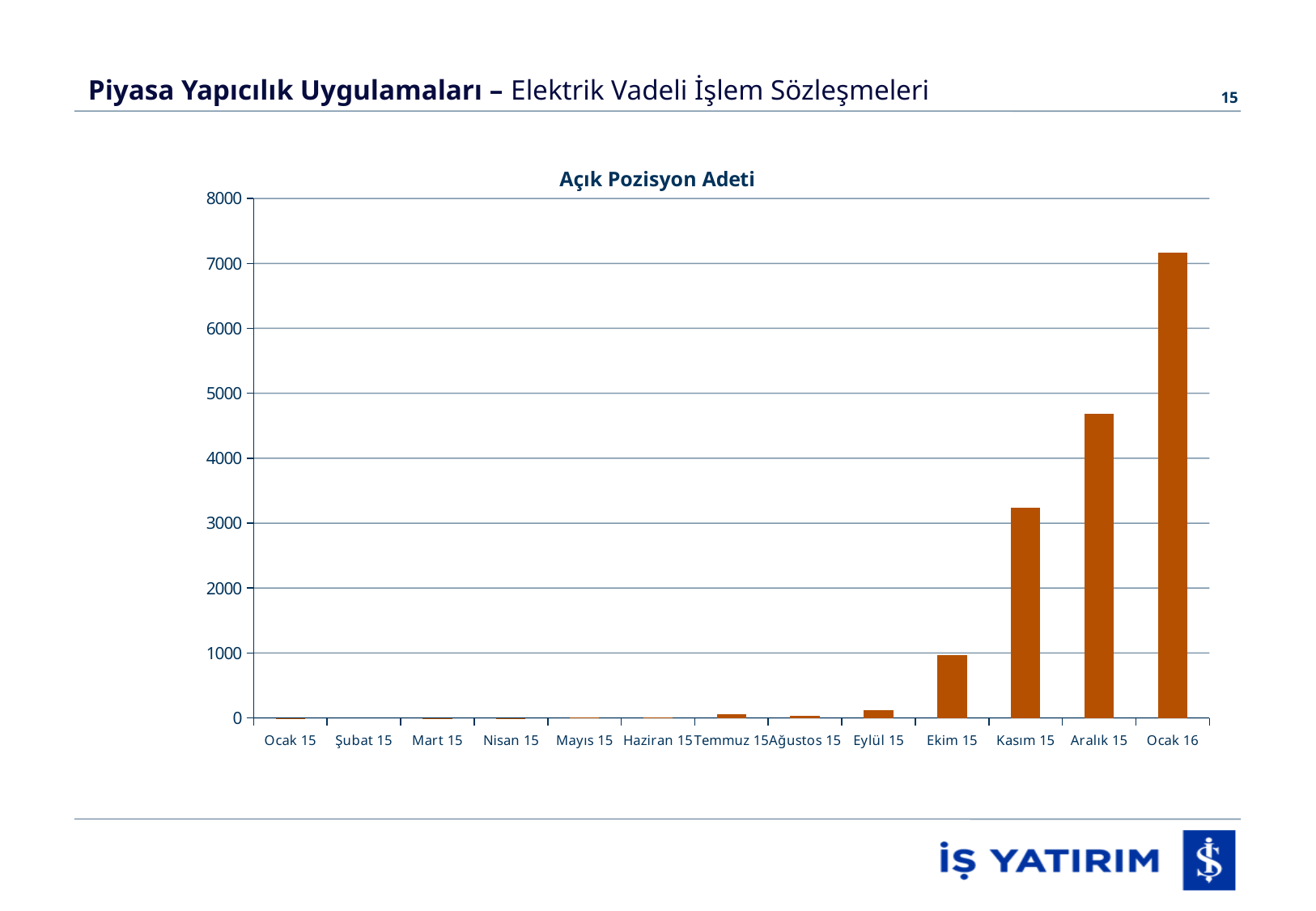
Is the value for Aralık 15 greater or less than 4000? greater Which is larger, the value for Kasım 15 or the value for Aralık 15? Aralık 15 Which month has the highest value in the chart? Ocak 16 Is the value for Kasım 15 greater or less than 3000? greater Is the value for Eylül 15 greater or less than 1000? less Do the values generally rise or fall from Ocak 15 to Ocak 16? rise Which is larger, the value for Ekim 15 or the value for Eylül 15? Ekim 15 What kind of chart is shown on the slide? bar chart What is the title of the chart? Açık Pozisyon Adeti How many months are shown on the x axis of the chart? 13